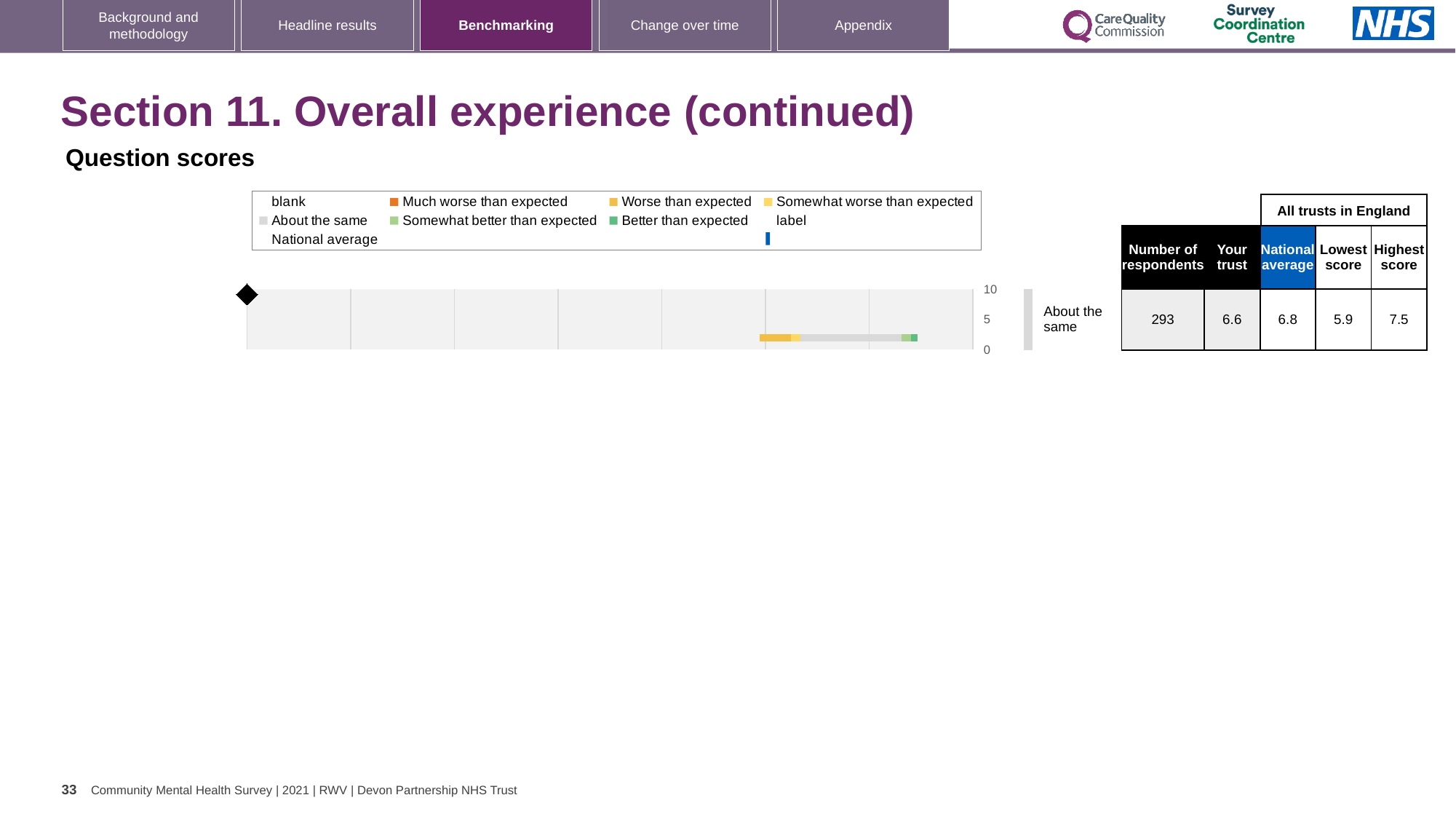
What kind of chart is shown on the slide? bar chart How many question categories are plotted in the chart? 1 What is the difference between the national average and the 'Your trust' score for the 'About the same' row? 0.2 What is the lowest score among all trusts in England for the 'About the same' row? 5.9 How many respondents are recorded for the 'About the same' row? 293 What is the difference between the highest score and the lowest score for the 'About the same' row? 1.6 What is the highest value shown on the chart's axis? 10 What is the highest score among all trusts in England for the 'About the same' row? 7.5 Which is larger for the 'About the same' row: the 'Your trust' score or the national average? National average What is the 'Your trust' score for the 'About the same' row? 6.6 What is the label of the single category plotted in the chart? About the same What is the national average score for the 'About the same' row? 6.8